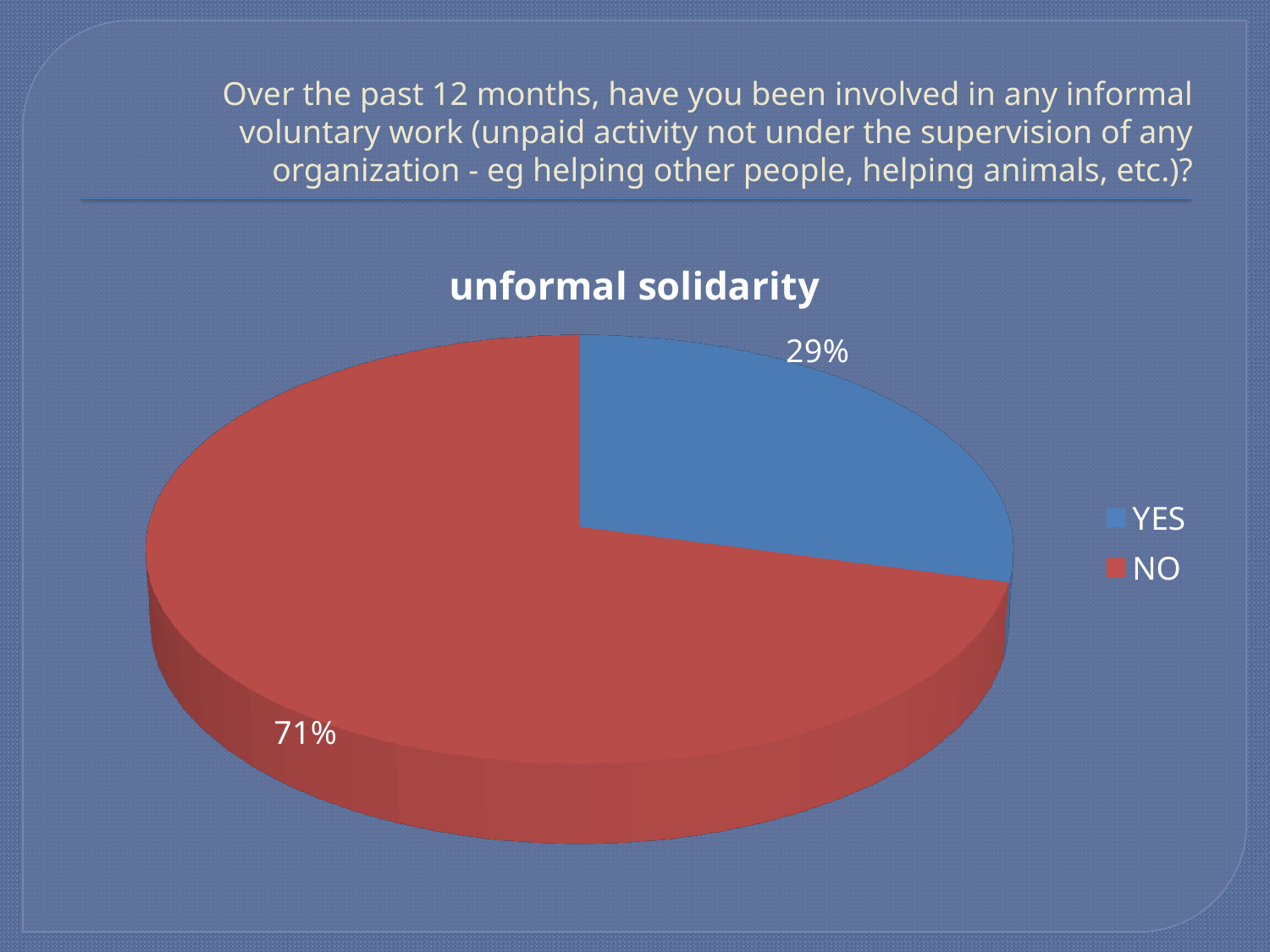
How many slices does the pie chart have? 2 What is the title of the chart? unformal solidarity What percentage of respondents answered NO? 71% What percentage of respondents answered YES? 29% What share of the pie does the YES slice represent? 29% Which answer has the largest share of the pie? NO What colour is the NO slice? red Which answer has the smallest share of the pie? YES How many entries does the legend list? 2 Which is larger, the YES share or the NO share? NO What kind of chart is shown on the slide? pie chart What is the difference in percentage points between the NO and YES shares? 42